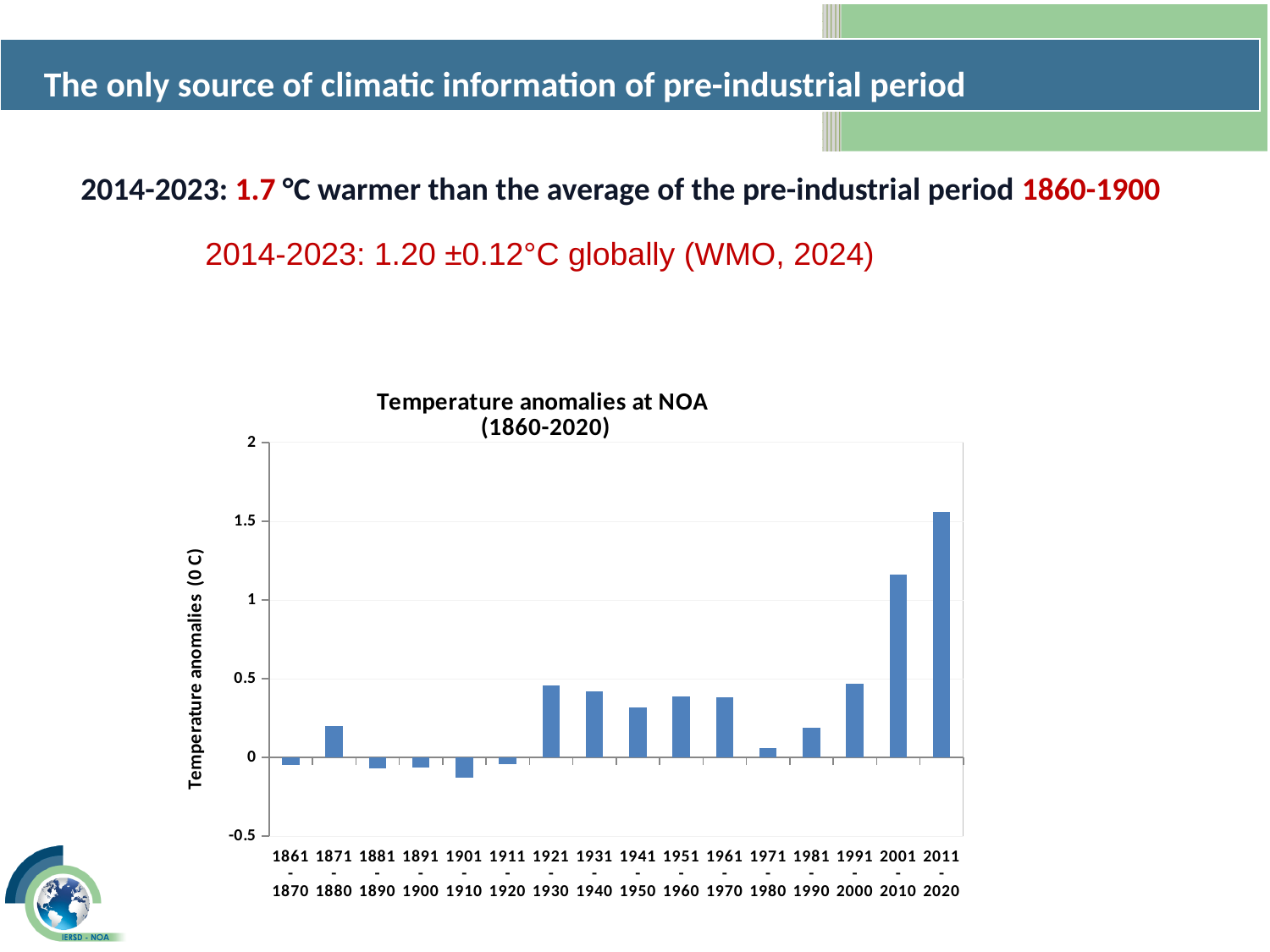
Is the value for 1971-1980 greater or less than 0.5? less How many decade categories are plotted on the x axis of the chart? 16 What kind of chart is shown on the slide? bar chart Which decade has the larger temperature anomaly, 2001-2010 or 1991-2000? 2001-2010 How many decades in the chart have a negative temperature anomaly? 5 Which decade has the larger temperature anomaly, 1921-1930 or 1971-1980? 1921-1930 Which decade has the lowest temperature anomaly in the chart? 1901-1910 Is the value for 1941-1950 greater or less than 0.5? less Is the value for 2001-2010 greater or less than 1? greater What is the title of the chart? Temperature anomalies at NOA (1860-2020) Which decade has the highest temperature anomaly in the chart? 2011-2020